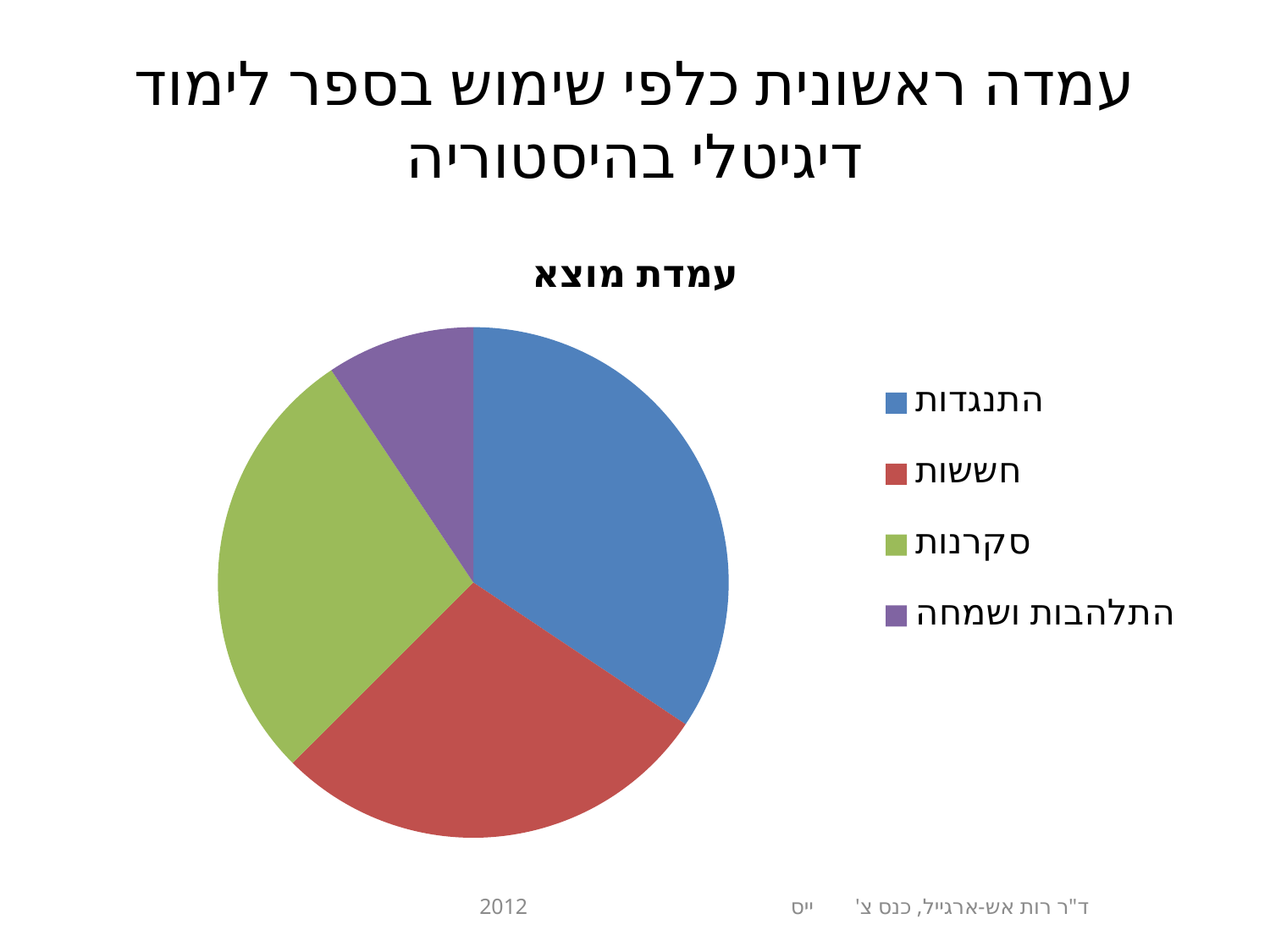
Which slice is larger, חששות or התלהבות ושמחה? חששות Which category has the smallest slice of the pie? התלהבות ושמחה What colour is the slice for סקרנות? green Which category has the largest slice of the pie? התנגדות How many slices does the pie chart have? 4 How many entries does the legend list? 4 What kind of chart is shown on the slide? pie chart What is the title of the chart? עמדת מוצא Which slice is larger, התנגדות or התלהבות ושמחה? התנגדות Which slice is larger, התנגדות or חששות? התנגדות